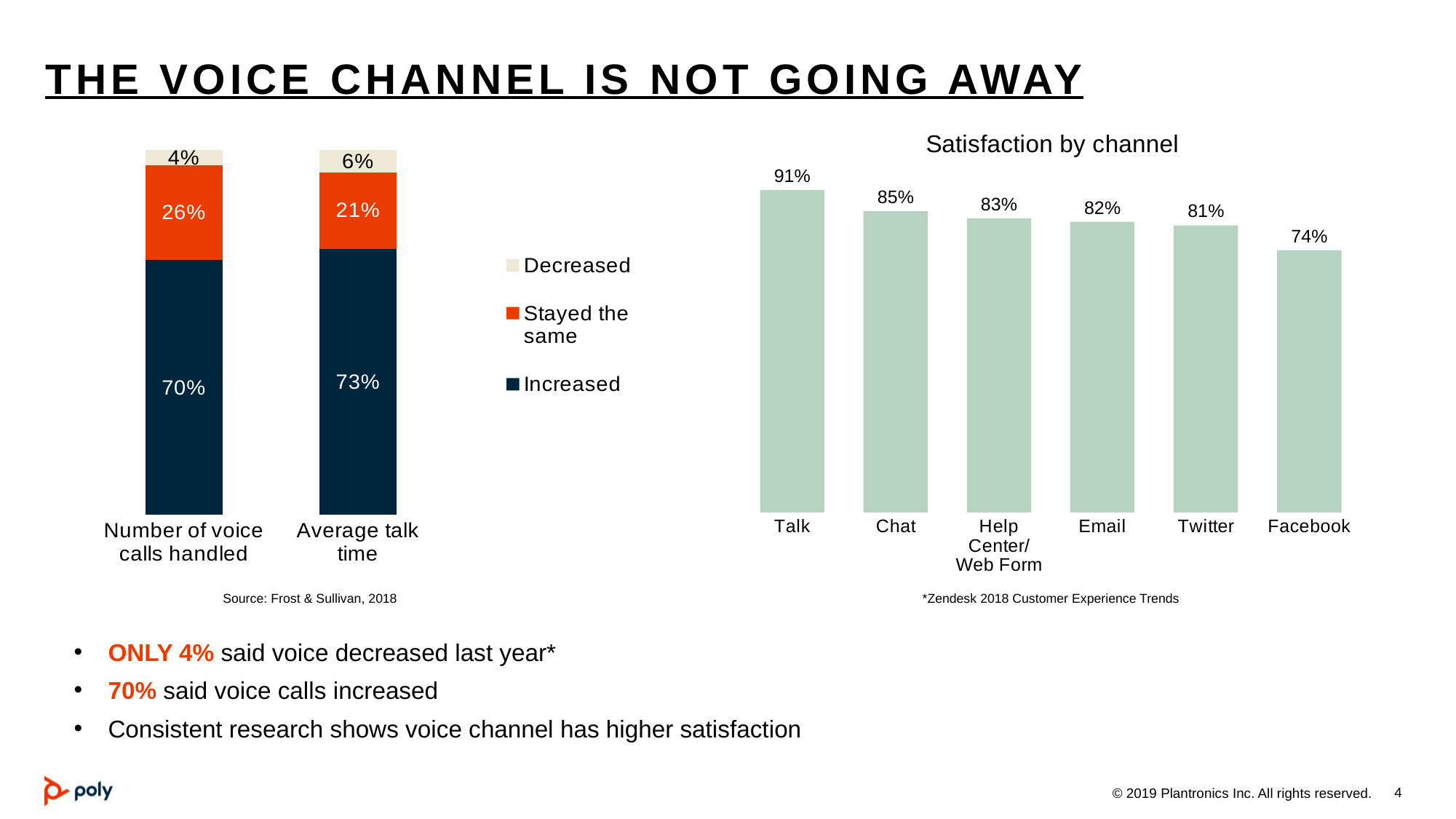
What kind of chart is the 'Satisfaction by channel' chart? Bar chart In the 'Satisfaction by channel' chart, what is the difference between Talk and Facebook? 17% In the left stacked bar chart, what percentage said average talk time decreased? 6% In the left stacked bar chart, what percentage said average talk time stayed the same? 21% In the left stacked bar chart, which legend entry is shown in orange? Stayed the same In the left stacked bar chart, how many series does the legend list? 3 In the 'Satisfaction by channel' chart, how many channels are shown? 6 In the 'Satisfaction by channel' chart, which channel has the lowest satisfaction? Facebook In the left stacked bar chart, what percentage said the number of voice calls handled increased? 70% In the 'Satisfaction by channel' chart, which channel has the highest satisfaction? Talk In the 'Satisfaction by channel' chart, what is the satisfaction value for Email? 82% In the left stacked bar chart, what is the total of the 'Number of voice calls handled' bar? 100%